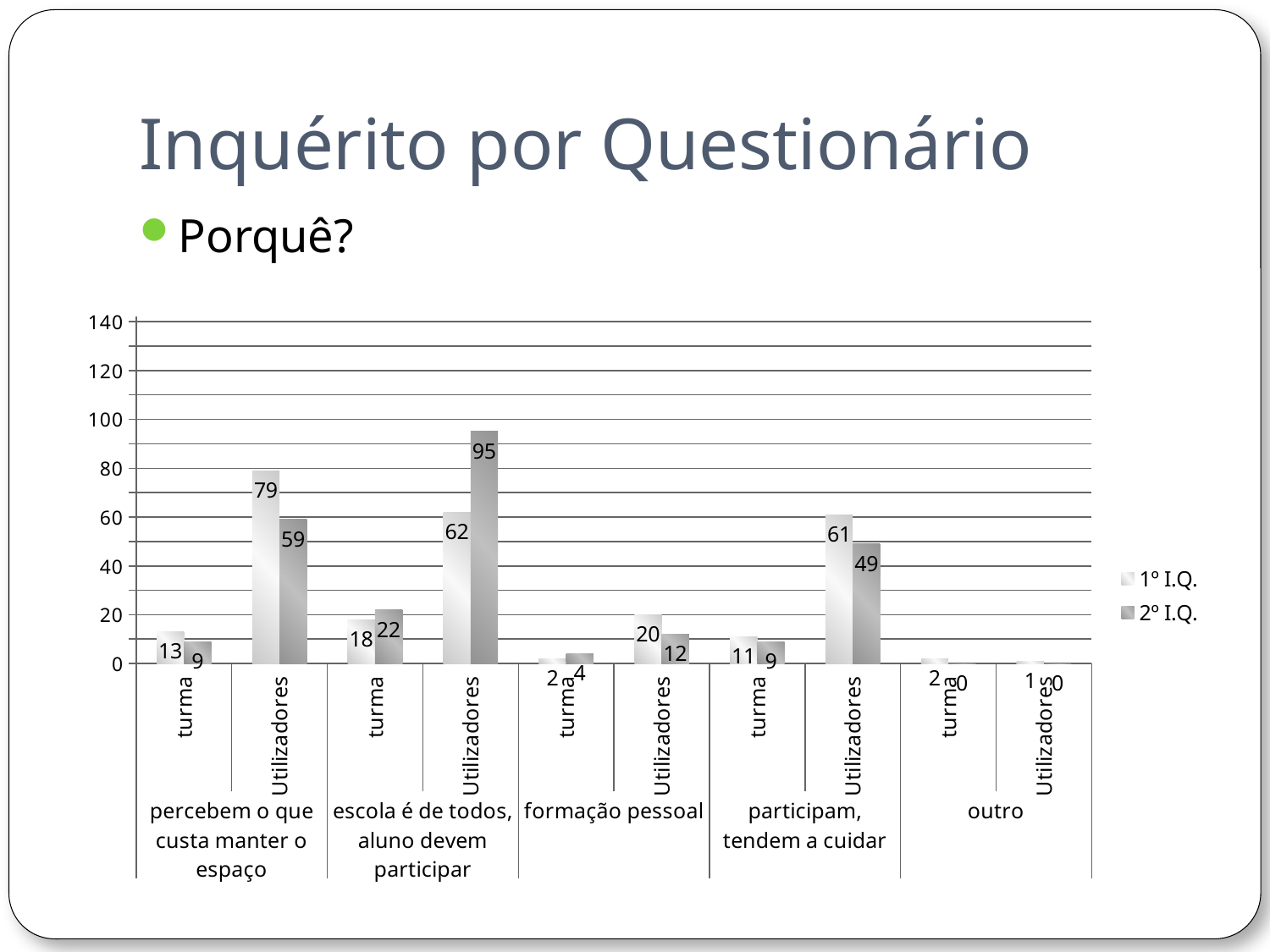
Which bar has the highest value in the whole chart? 2º I.Q. for Utilizadores in "escola é de todos, aluno devem participar" (95) What is the 1º I.Q. value for turma in the group "formação pessoal"? 2 Is the 1º I.Q. value for Utilizadores in "participam, tendem a cuidar" greater or less than 60? greater What are the two series names shown in the legend? 1º I.Q. and 2º I.Q. What is the 1º I.Q. value for Utilizadores in the group "percebem o que custa manter o espaço"? 79 What kind of chart is shown on the slide? Bar chart What is the difference between the 2º I.Q. and 1º I.Q. values for Utilizadores in "escola é de todos, aluno devem participar"? 33 For Utilizadores in "formação pessoal", which is larger: the 1º I.Q. value or the 2º I.Q. value? 1º I.Q. How many series does the legend list? 2 What is the 2º I.Q. value for Utilizadores in the group "participam, tendem a cuidar"? 49 What is the difference between the 1º I.Q. and 2º I.Q. values for Utilizadores in "percebem o que custa manter o espaço"? 20 What is the 2º I.Q. value for Utilizadores in the group "escola é de todos, aluno devem participar"? 95